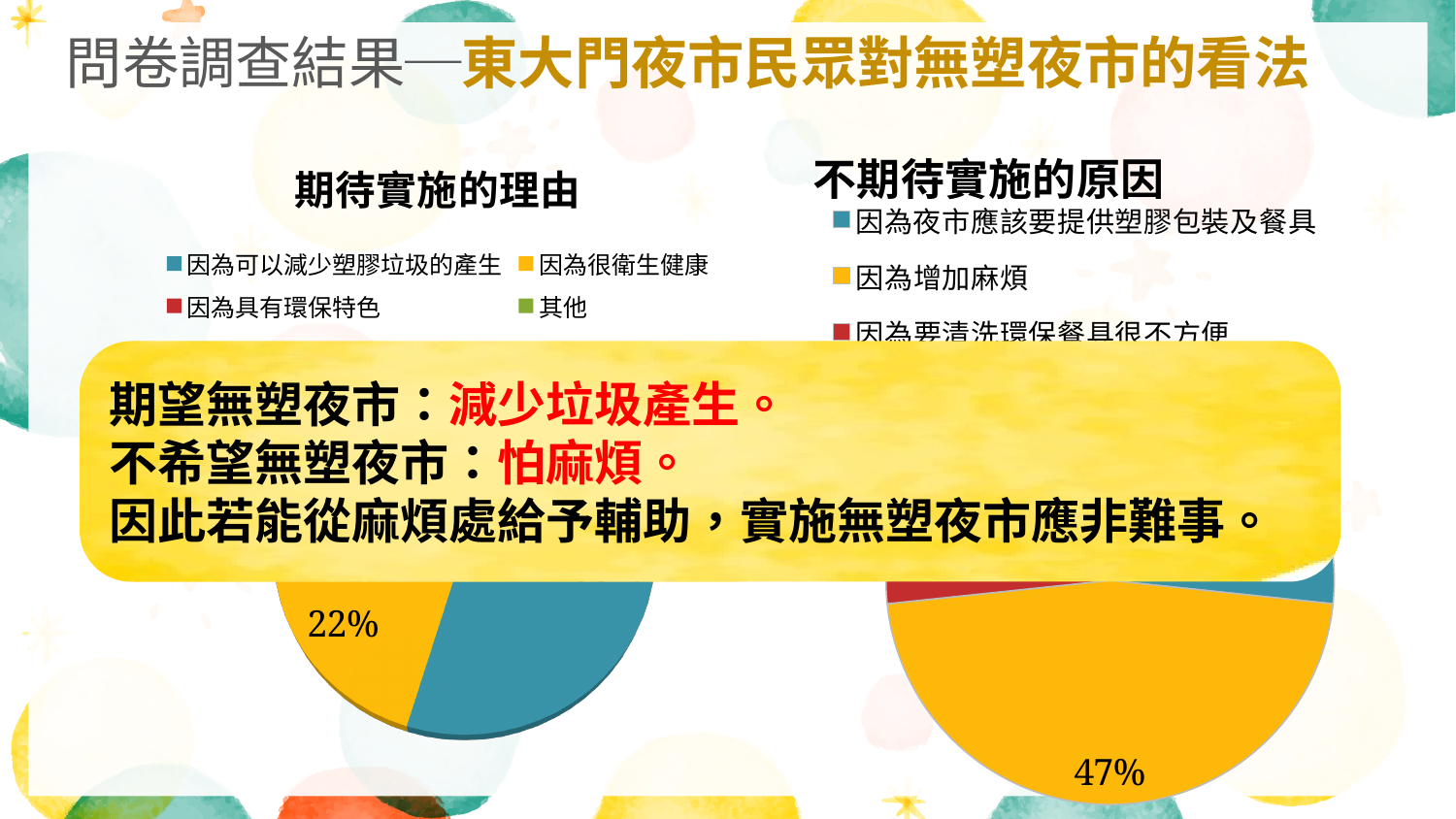
In the chart titled 不期待實施的原因, what percentage is shown for 因為增加麻煩? 47% What kind of chart is the chart titled 期待實施的理由? pie chart What kind of chart is the chart titled 不期待實施的原因? pie chart In the chart titled 期待實施的理由, which category is shown in blue? 因為可以減少塑膠垃圾的產生 In the chart titled 不期待實施的原因, which category is shown in yellow? 因為增加麻煩 How many categories does the legend of the chart titled 期待實施的理由 list? 4 In the chart titled 期待實施的理由, is the share for 因為很衛生健康 greater or less than 30%? less In the chart titled 不期待實施的原因, is the share for 因為增加麻煩 greater or less than 40%? greater In the chart titled 期待實施的理由, what percentage is shown for 因為很衛生健康? 22%